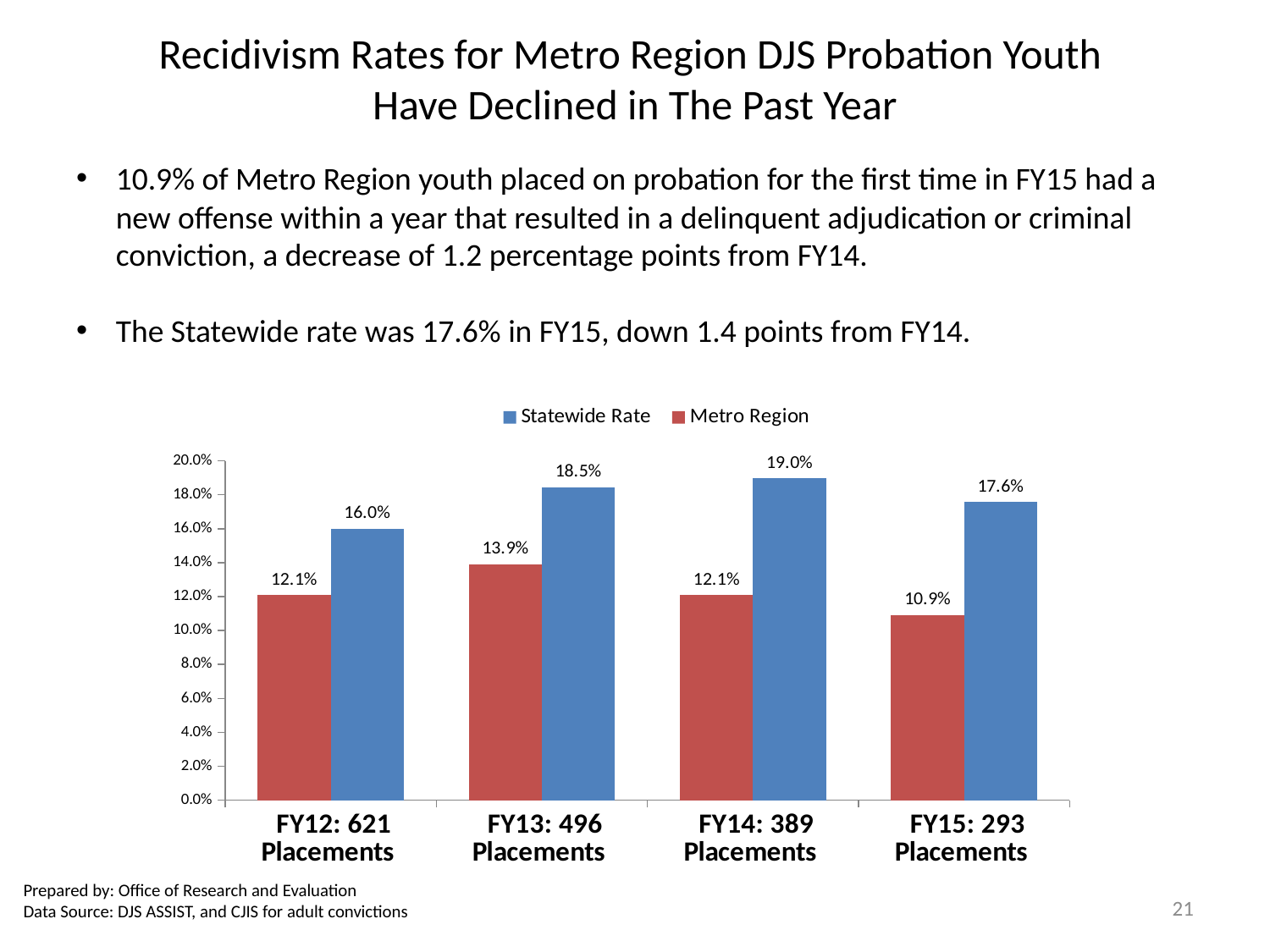
Which fiscal year has the lowest Metro Region rate? FY15: 293 Placements What colour are the Metro Region bars? Red Which fiscal year has the highest Statewide Rate? FY14: 389 Placements Is the Statewide Rate for FY15: 293 Placements greater or less than 16.0%? greater What is the difference between the Statewide Rate and the Metro Region rate for FY13: 496 Placements? 4.6 percentage points What is the Metro Region rate for FY13: 496 Placements? 13.9% What kind of chart is shown on the slide? Bar chart What is the Statewide Rate for FY14: 389 Placements? 19.0% Which is larger for FY12: 621 Placements, the Statewide Rate or the Metro Region rate? Statewide Rate What is the Metro Region recidivism rate for FY15: 293 Placements? 10.9% How many series does the legend list? 2 How many fiscal year categories are shown on the x axis? 4